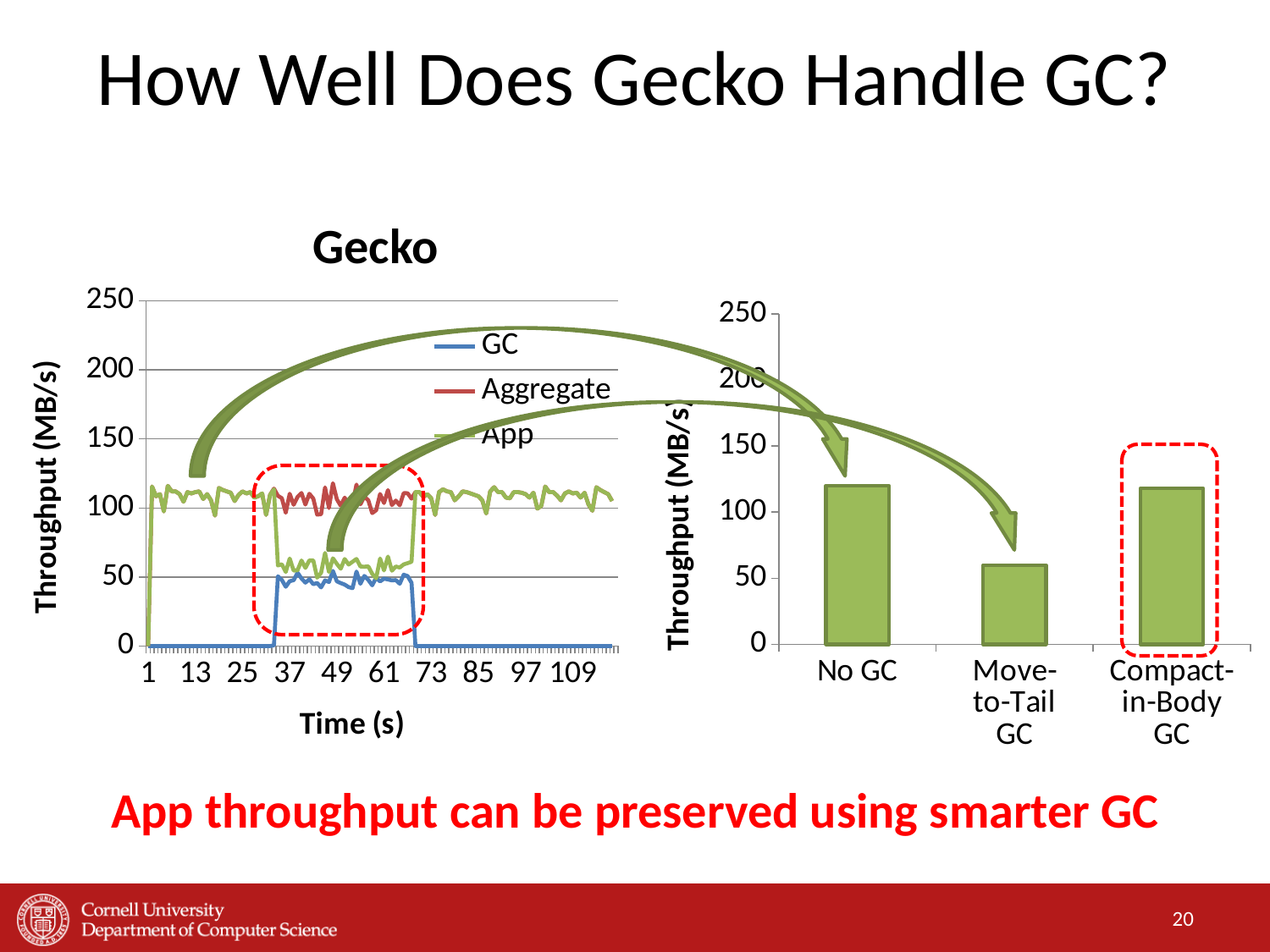
What is the x-axis label of the "Gecko" line chart? Time (s) In the bar chart on the right, how many categories are shown? 3 In the "Gecko" line chart, is the App value at time 13 greater or less than 100? greater What kind of chart is the chart titled "Gecko" on the left? line chart In the bar chart on the right, which is larger: the value for No GC or the value for Move-to-Tail GC? No GC In the bar chart on the right, is the value for No GC greater or less than 100? greater In the bar chart on the right, is the value for Move-to-Tail GC greater or less than 100? less In the bar chart on the right, which is larger: the value for Compact-in-Body GC or the value for Move-to-Tail GC? Compact-in-Body GC In the bar chart on the right, which category has the lowest throughput? Move-to-Tail GC What kind of chart is the chart on the right of the slide? bar chart How many series does the legend of the "Gecko" line chart list? 3